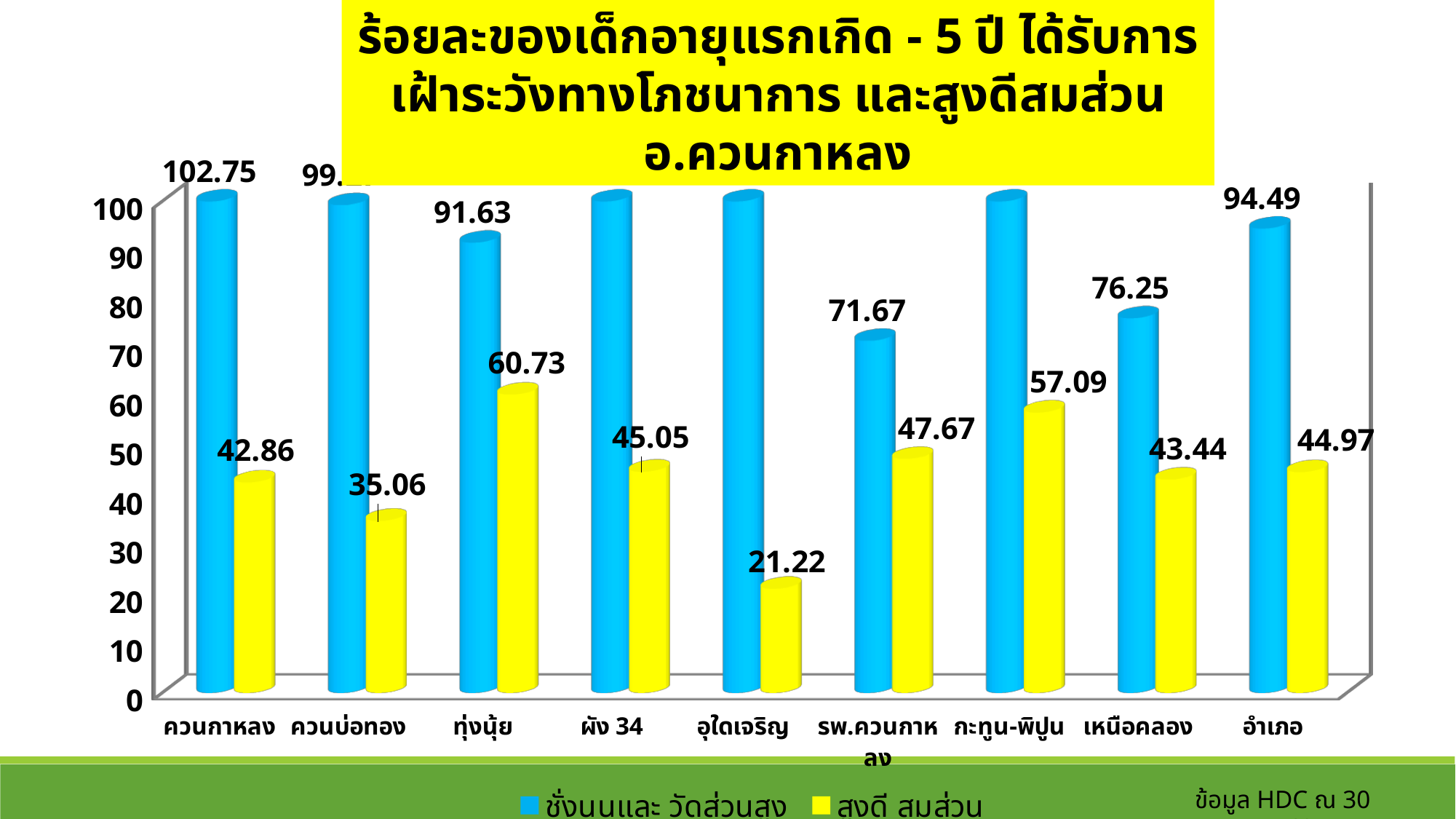
What is the value of the blue (ชั่งน้ำหนักและวัดส่วนสูง) bar for เหนือคลอง? 76.25 What is the value of the blue bar for รพ.ควนกาหลง? 71.67 Is the value of the blue bar for ผัง 34 greater or less than 90? greater Which has a larger yellow bar, กะทูน-พิปูน or รพ.ควนกาหลง? กะทูน-พิปูน What is the value of the yellow (สูงดี สมส่วน) bar for ทุ่งนุ้ย? 60.73 What is the difference between the blue and yellow bars for อำเภอ? 49.52 How many series does the legend list? 2 Which category has the lowest blue bar? รพ.ควนกาหลง How many categories are shown on the x axis? 9 Which category has the lowest yellow (สูงดี สมส่วน) bar? อุใดเจริญ What is the value of the yellow bar for อุใดเจริญ? 21.22 Which category has the highest yellow (สูงดี สมส่วน) bar? ทุ่งนุ้ย